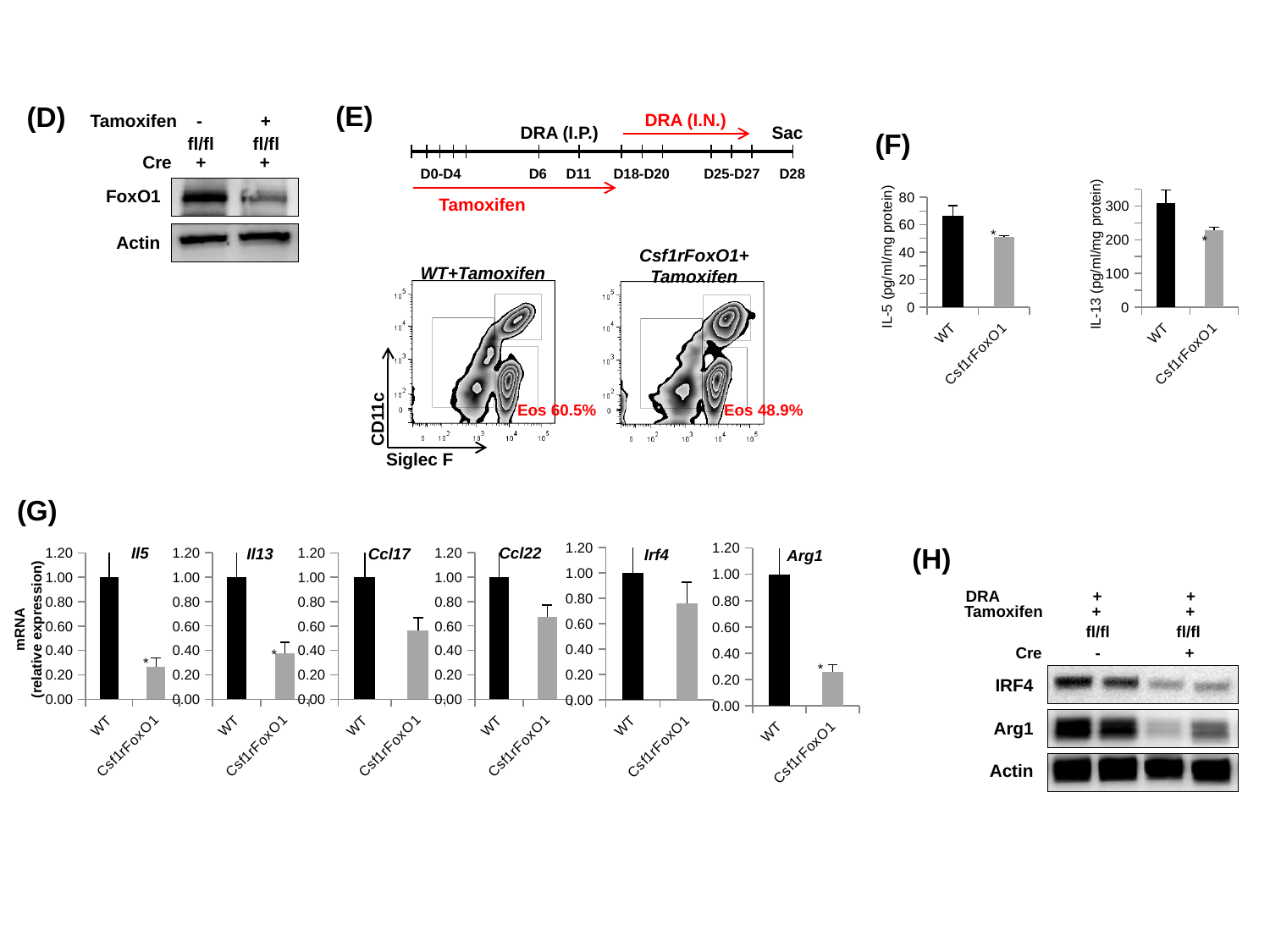
In panel E, what eosinophil percentage is printed on the WT+Tamoxifen flow cytometry plot? Eos 60.5% In panel F, what is the y-axis label of the IL-13 chart? IL-13 (pg/ml/mg protein) In panel F, on the IL-5 chart, which group has the larger value, WT or Csf1rFoxO1? WT In panel G, on the Il5 chart, is the value for Csf1rFoxO1 greater or less than 0.40? less How many bar charts are shown in panel G? 6 In panel G, on the Il5 chart, what is the relative expression value for WT? 1.00 In panel F, on the IL-13 chart, is the value for WT greater or less than 200? greater In panel F, what kind of chart is the IL-5 chart? bar chart In panel F, on the IL-5 chart, is the value for Csf1rFoxO1 greater or less than 60? less In panel G, on the Arg1 chart, which group has the larger value, WT or Csf1rFoxO1? WT In panel F, how many categories are shown on the x axis of the IL-5 chart? 2